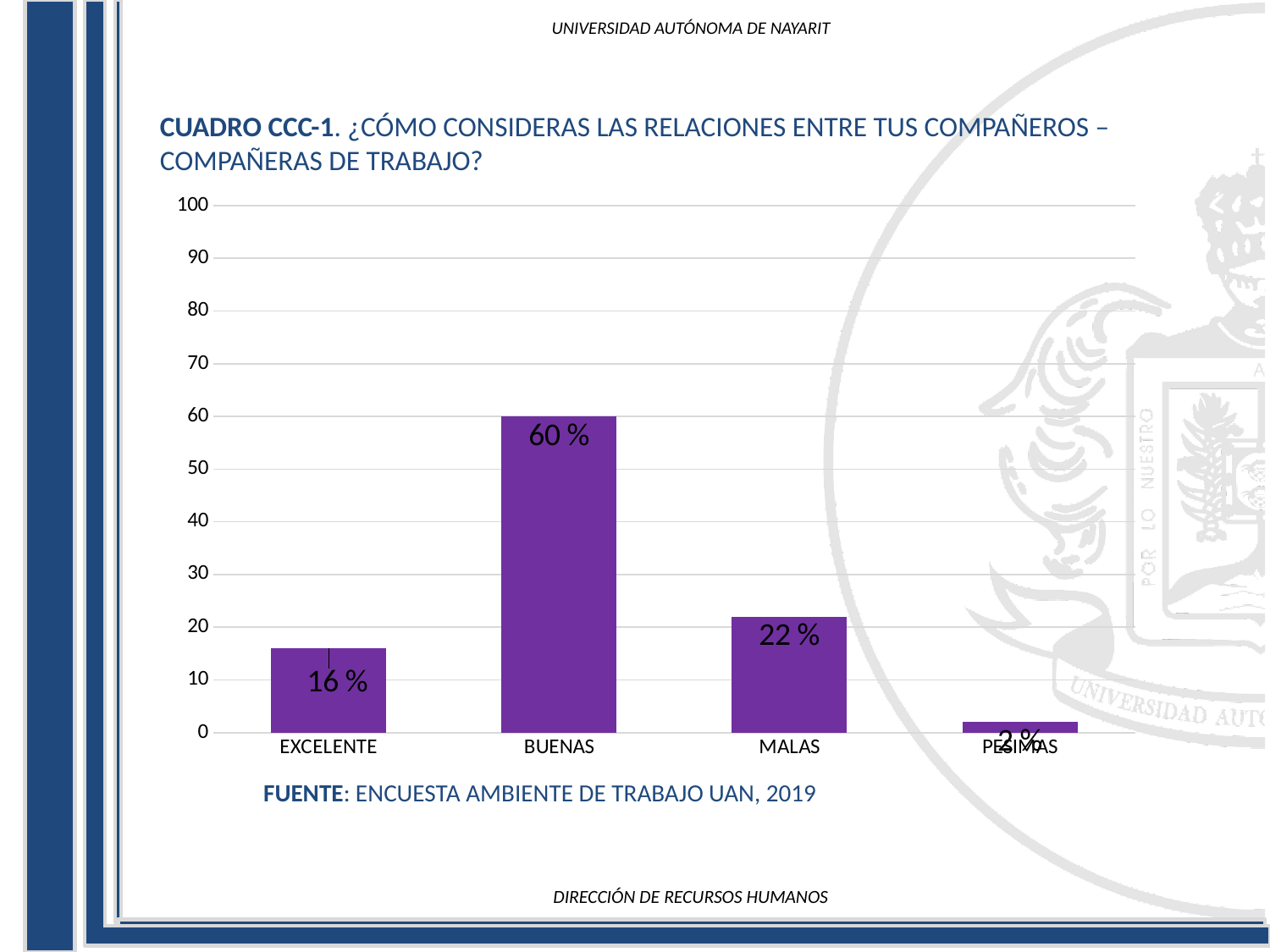
What is the value for EXCELENTE? 16 % What is the value for MALAS? 22 % What is the value for BUENAS? 60 % What is the difference between the values for BUENAS and MALAS? 38 % Is the value for BUENAS greater or less than 50? greater What kind of chart is shown on the slide? bar chart Which is larger, the value for MALAS or the value for EXCELENTE? MALAS What is the value for PÉSIMAS? 2 % How many categories are shown on the x axis? 4 What source is cited below the chart? ENCUESTA AMBIENTE DE TRABAJO UAN, 2019 Which category has the lowest value? PESIMAS Which category has the highest value? BUENAS